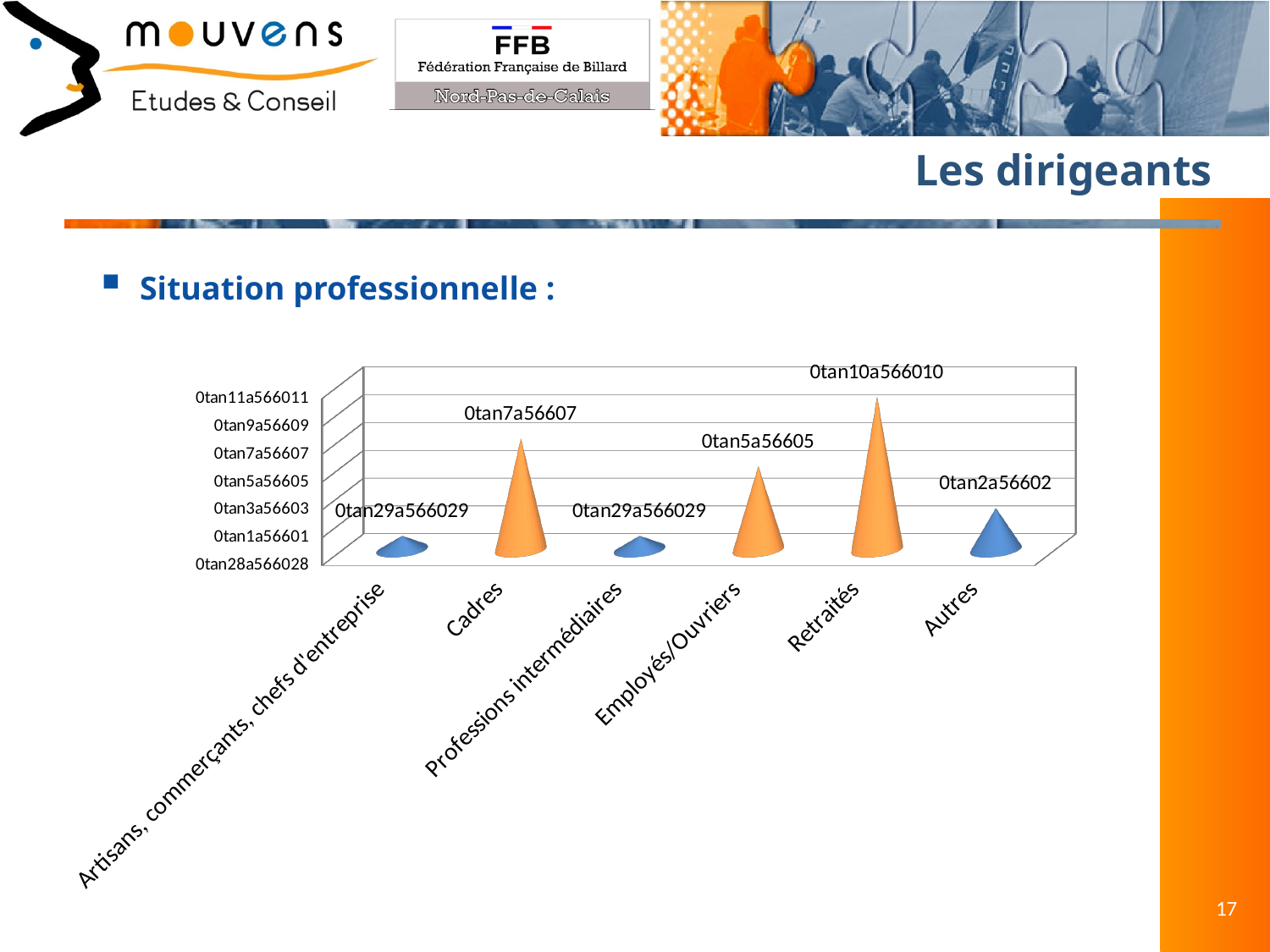
What is the first category listed on the x axis of the chart? Artisans, commerçants, chefs d'entreprise Which is larger, the value for Cadres or the value for Autres? Cadres Which is larger, the value for Cadres or the value for Employés/Ouvriers? Cadres Which is larger, the value for Employés/Ouvriers or the value for Professions intermédiaires? Employés/Ouvriers What is the heading printed above the chart? Situation professionnelle : How many categories are shown on the x axis of the chart? 6 What kind of chart is shown on the slide? bar chart Which category has the highest value in the chart? Retraités